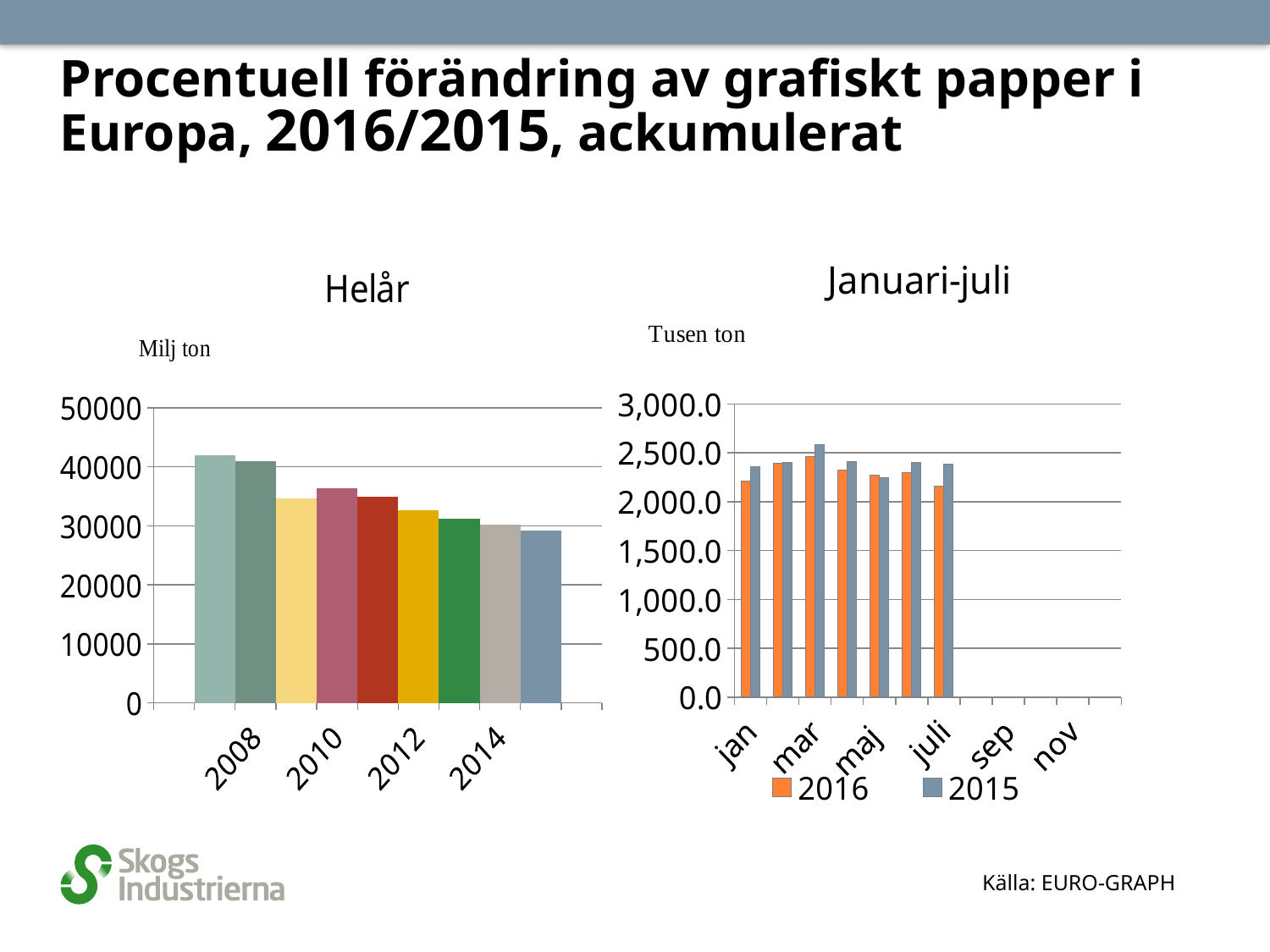
In the Helår chart, is the value for 2012 greater or less than 30000? greater What kind of chart is the Helår chart on the left? bar chart In the Helår chart, do the values generally rise or fall from left to right along the x axis? fall How many series does the legend of the Januari-juli chart list? 2 In the Helår chart, is the value for 2010 greater or less than 40000? less In the Januari-juli chart, which month has the highest bar? mar In the Januari-juli chart, which is larger for jan, the 2016 value or the 2015 value? 2015 In the Januari-juli chart, which is larger for juli, the 2016 value or the 2015 value? 2015 In the Helår chart, is the value for 2008 greater or less than 40000? greater What unit label is shown above the Januari-juli chart? Tusen ton